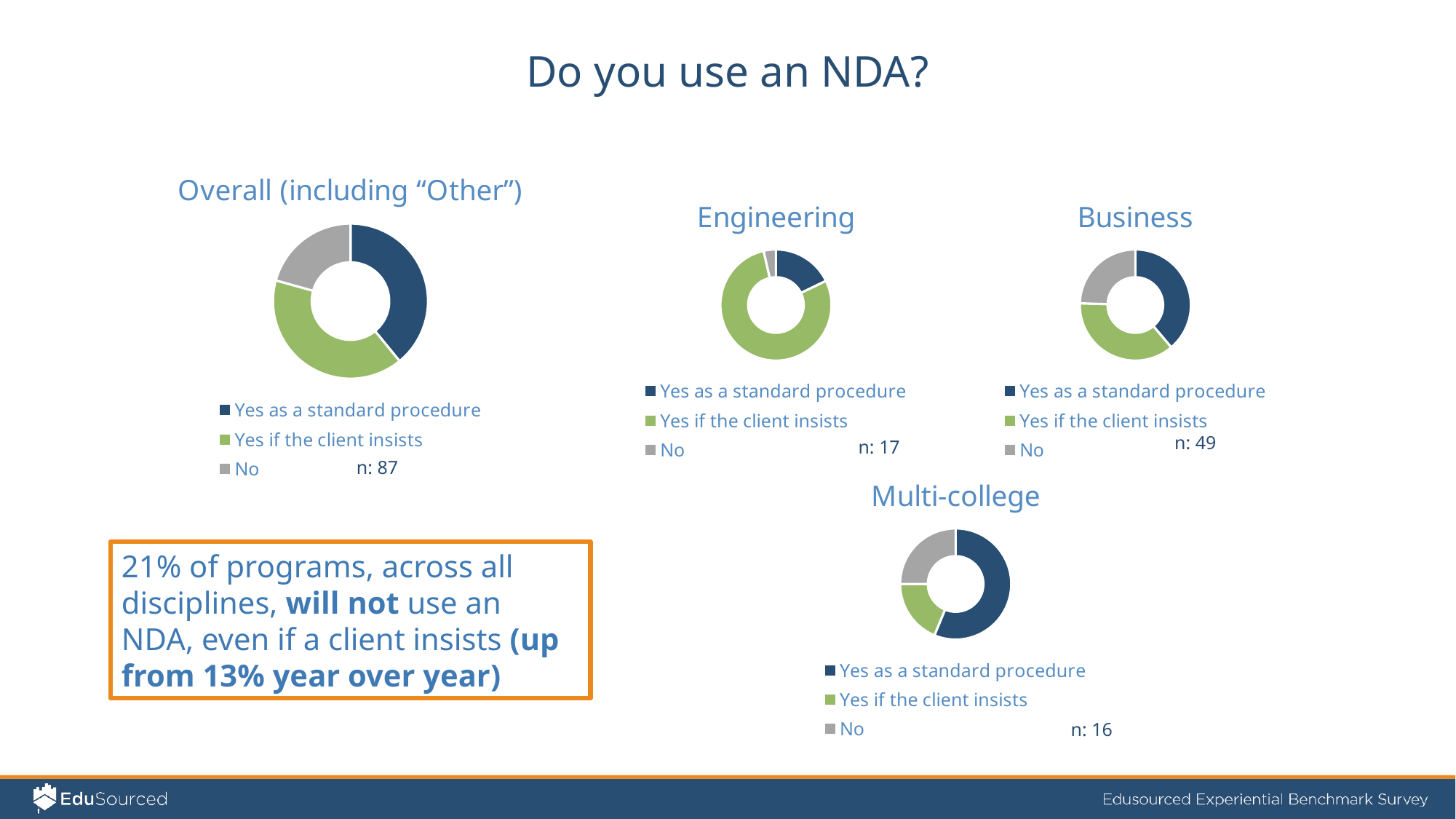
What is the sample size (n) shown for the Overall (including "Other") chart? n: 87 In the Multi-college chart, which slice is larger: "Yes as a standard procedure" or "No"? Yes as a standard procedure In the Engineering chart, which category has the smallest slice? No How many categories does the legend of the Engineering chart list? 3 In the Engineering chart, which slice is larger: "Yes as a standard procedure" or "Yes if the client insists"? Yes if the client insists What kind of chart is the Overall (including "Other") chart? Pie (donut) chart In the Engineering chart, which category has the largest slice? Yes if the client insists In the Business chart, which slice is larger: "Yes as a standard procedure" or "No"? Yes as a standard procedure What is the sample size (n) shown for the Business chart? n: 49 In the Overall (including "Other") chart, which category has the smallest slice? No In the Business chart, which category has the smallest slice? No In the Multi-college chart, which category has the largest slice? Yes as a standard procedure